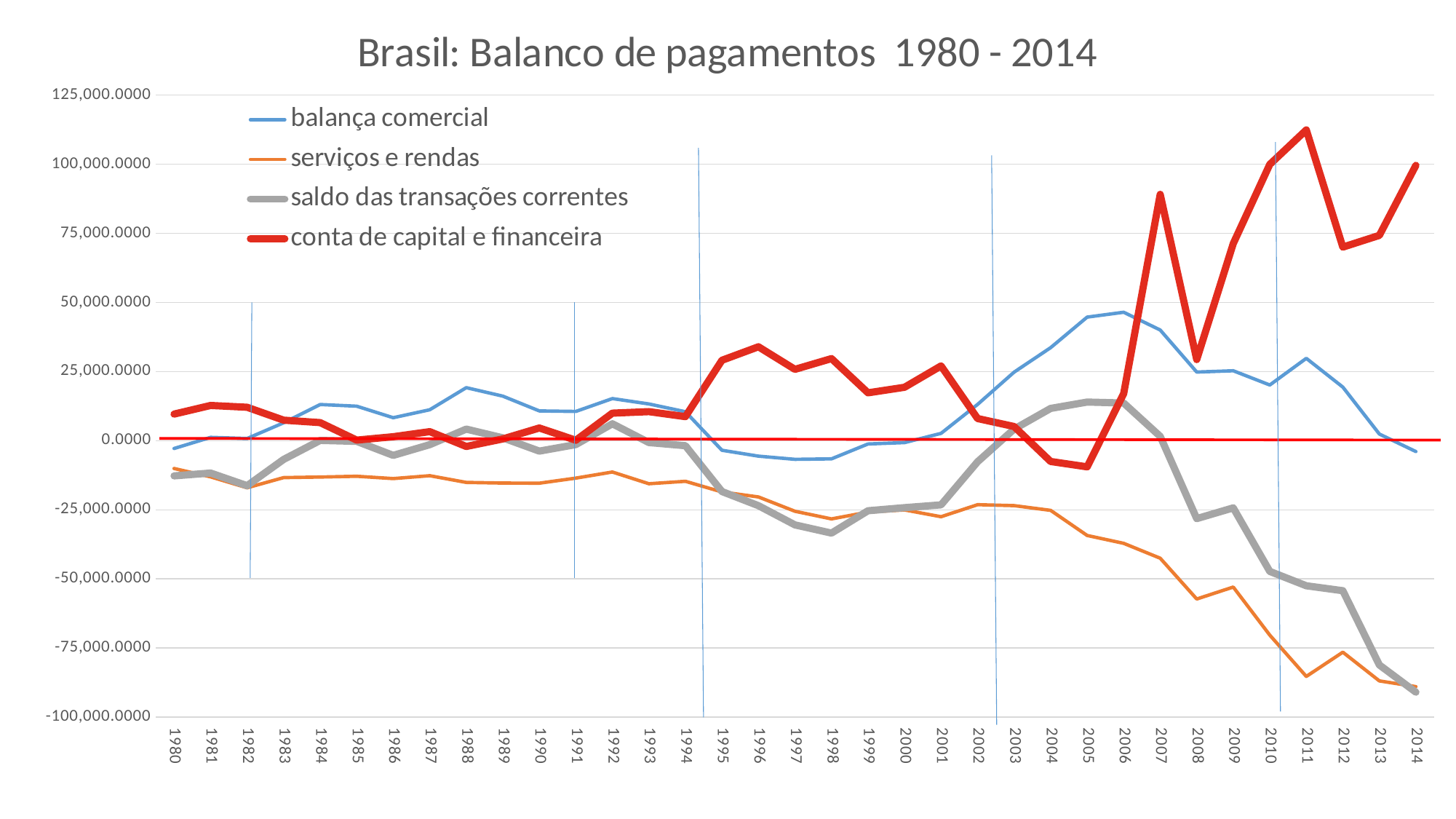
In 2014, which is higher: balança comercial or conta de capital e financeira? conta de capital e financeira In which year does conta de capital e financeira reach its highest value? 2011 Is the value for saldo das transações correntes in 1998 greater or less than -25,000? less What is the title of the chart? Brasil: Balanco de pagamentos 1980 - 2014 Is the value for conta de capital e financeira in 2011 greater or less than 100,000? greater What kind of chart is shown on the slide? line chart How many years are plotted along the x axis? 35 In which year does saldo das transações correntes reach its lowest value? 2014 Which series is drawn as the thick red line? conta de capital e financeira How many series does the legend list? 4 Is the value for serviços e rendas in 2011 greater or less than -75,000? less